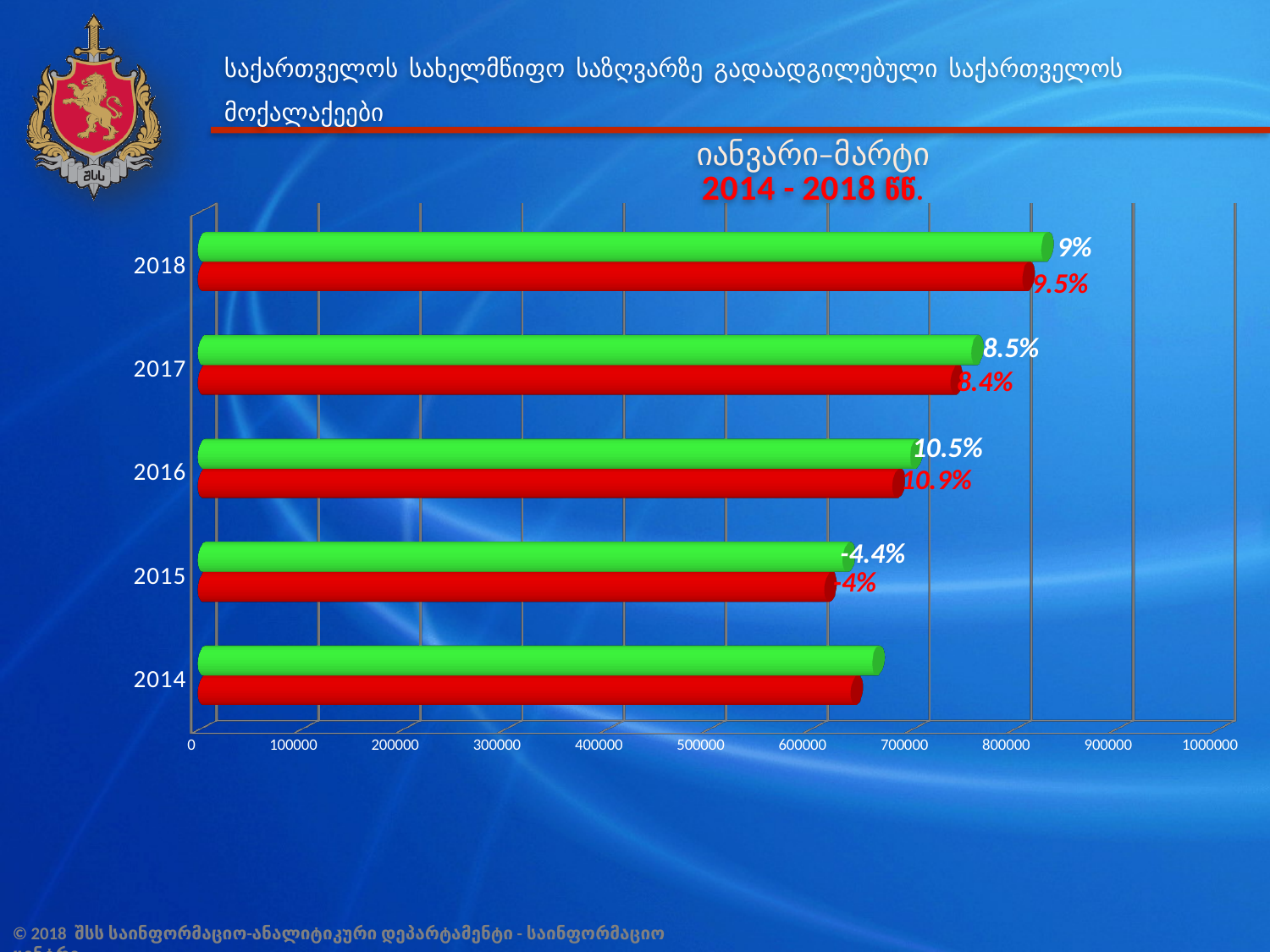
Is the green bar for 2015 greater or less than 700000? less How many years are shown on the vertical axis of the chart? 5 Which is longer, the green bar for 2017 or the green bar for 2014? 2017 Is the red bar for 2015 greater or less than 600000? greater Is the green bar for 2018 greater or less than 800000? greater What kind of chart is shown on the slide? bar chart Which year has the shortest green bar? 2015 What percentage label is printed next to the red bar for 2018? 9.5% What is the highest value shown on the horizontal axis of the chart? 1000000 What percentage label is printed next to the green bar for 2016? 10.5% Which year has the longest green bar? 2018